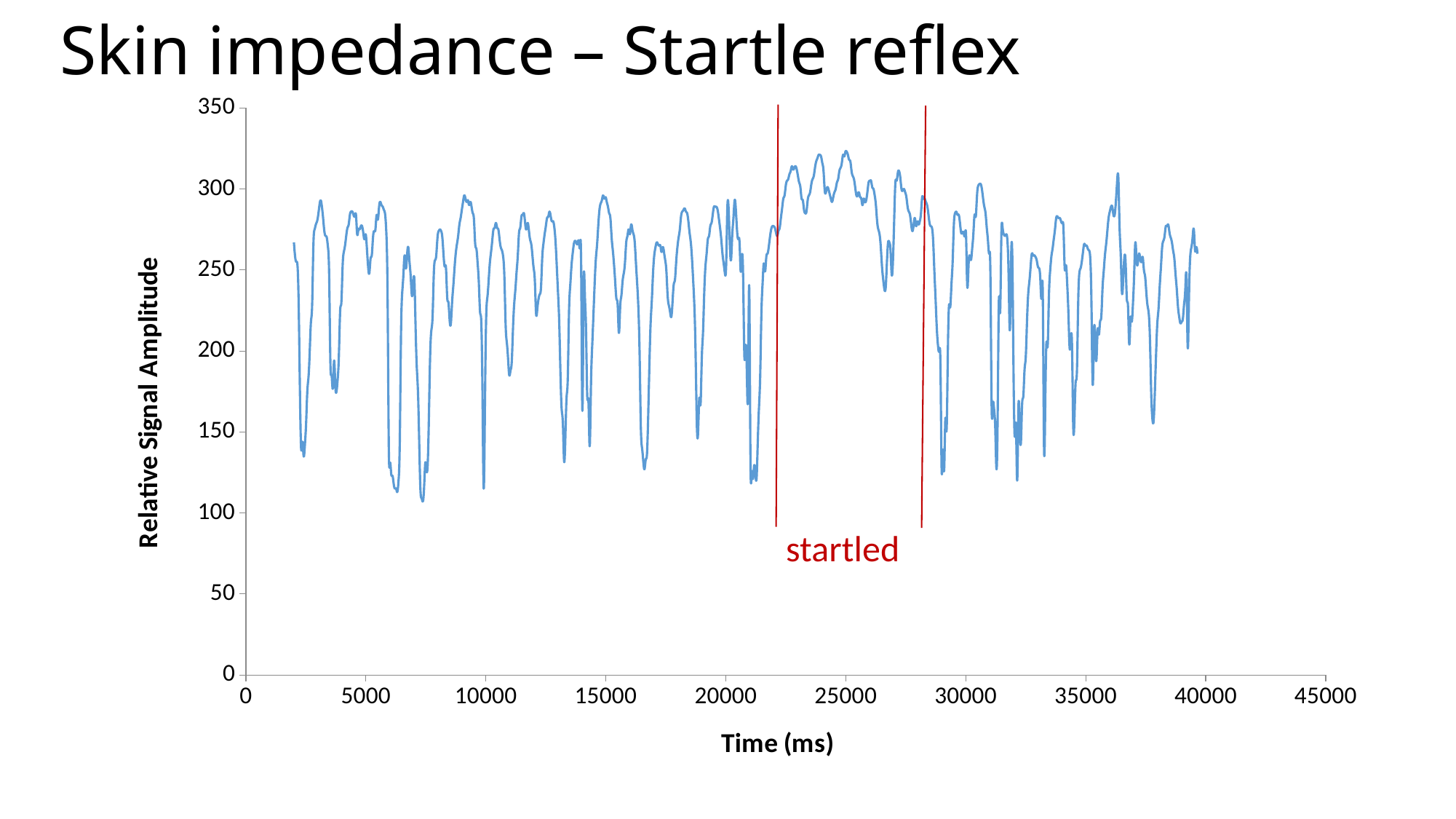
Within the 'startled' region between the red lines, does the signal stay greater or less than 200? greater What is the highest value shown on the x axis? 45000 How many data series are plotted on the chart? 1 What is the label of the y axis? Relative Signal Amplitude Is the lowest value of the signal around 6000 ms greater or less than 150? less What is the label of the x axis? Time (ms) Is the lowest value of the signal around 7500 ms greater or less than 150? less What kind of chart is shown on the slide? line chart